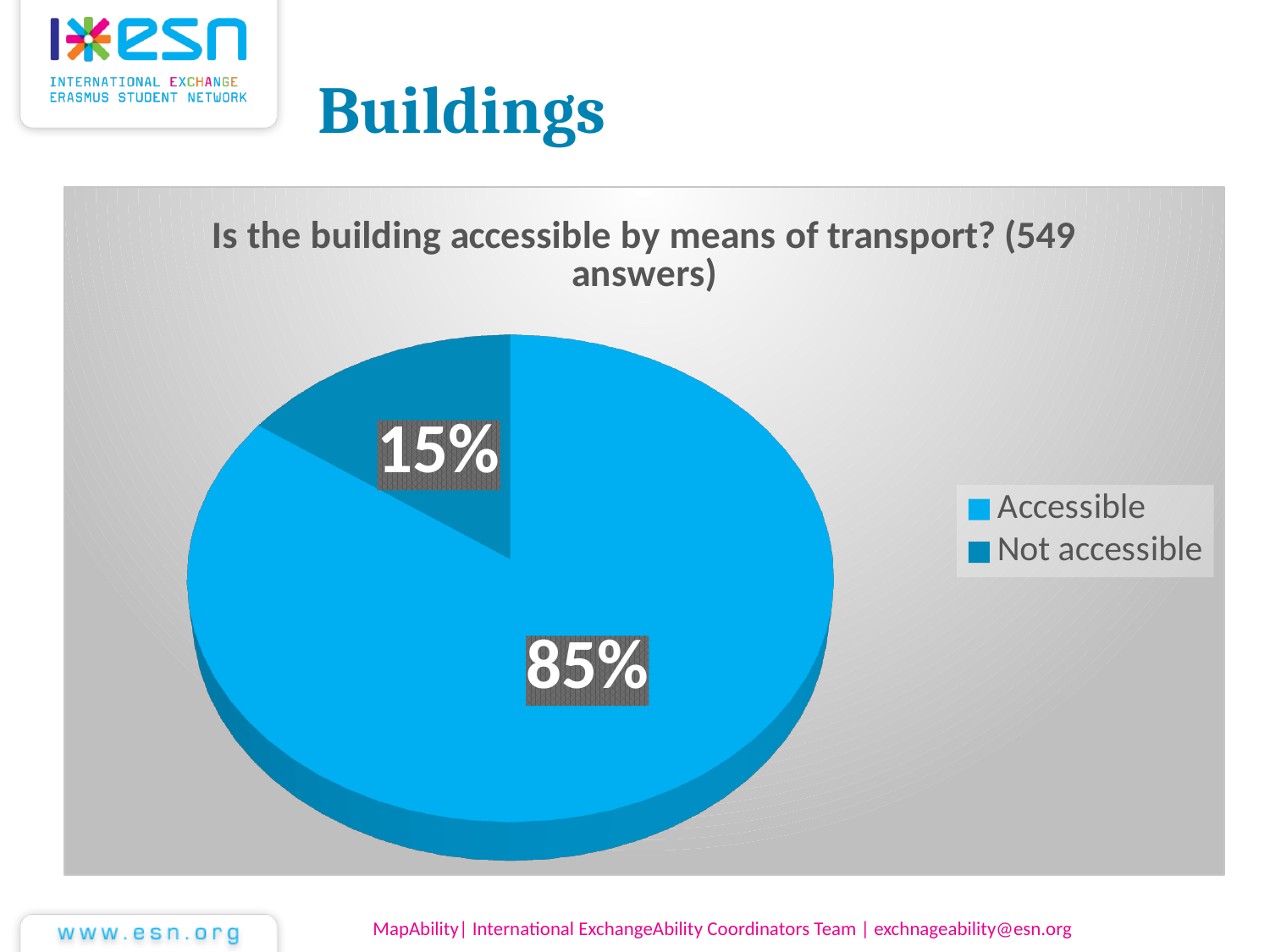
What percentage of the pie is labelled Not accessible? 15% What is the difference in percentage points between the Accessible and Not accessible slices? 70 Is the share for Not accessible greater or less than 50%? less Which slice is larger, Accessible or Not accessible? Accessible What kind of chart is shown on the slide? Pie chart Which category has the smallest share of the pie? Not accessible How many entries does the legend list? 2 How many answers does the chart title say the data is based on? 549 What is the title of the chart? Is the building accessible by means of transport? (549 answers) What percentage of the pie is labelled Accessible? 85% How many slices does the pie chart have? 2 Which category has the largest share of the pie? Accessible